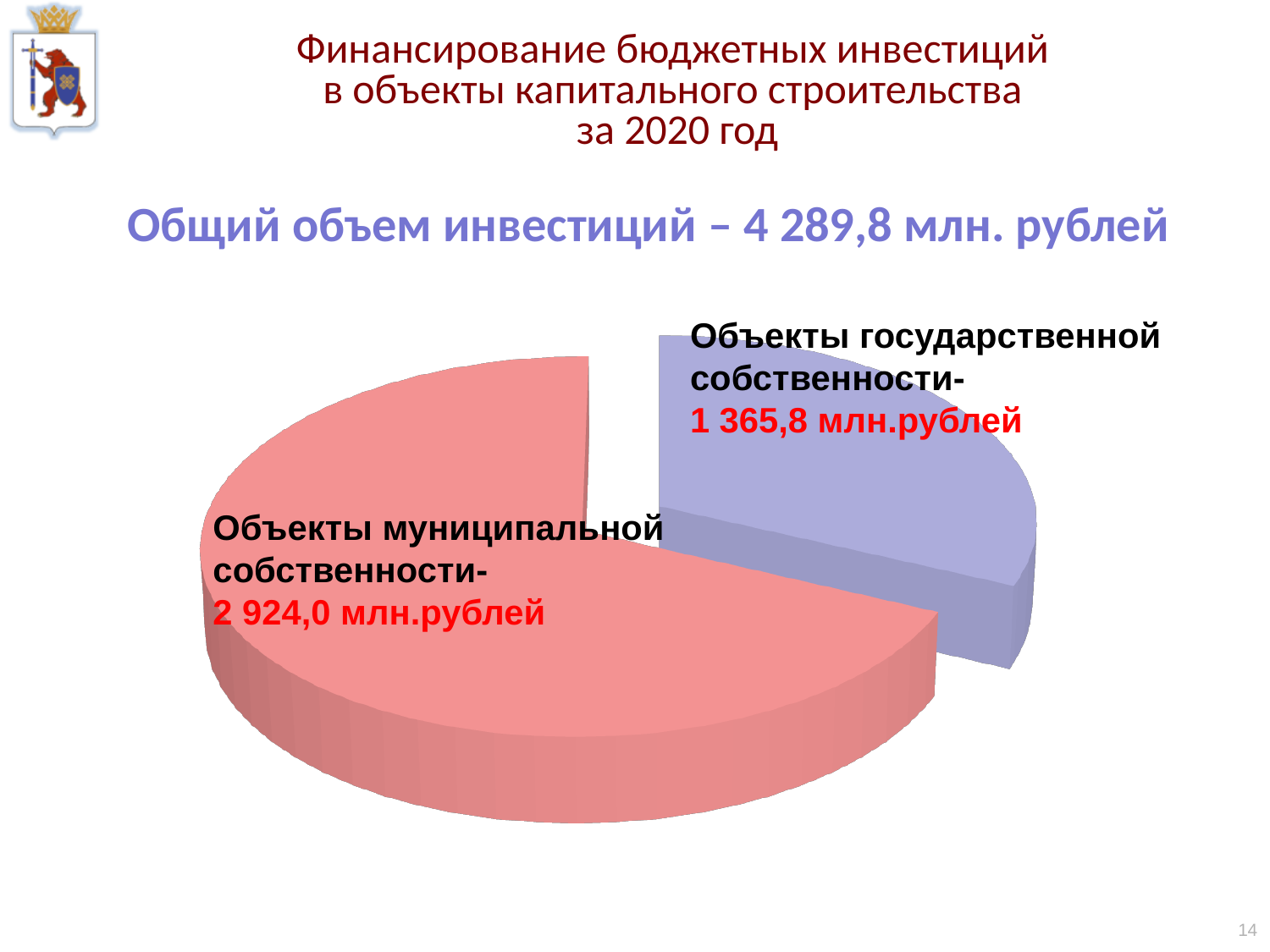
Which category has the smallest slice of the pie? Объекты государственной собственности What is the value for Объекты муниципальной собственности? 2 924,0 млн.рублей How many slices does the pie chart have? 2 Which category has the largest slice of the pie? Объекты муниципальной собственности What is the value for Объекты государственной собственности? 1 365,8 млн.рублей What colour is the slice for Объекты государственной собственности? Blue Which is larger: the value for Объекты муниципальной собственности or for Объекты государственной собственности? Объекты муниципальной собственности What is the total of the two slices in the pie chart? 4 289,8 млн. рублей What total investment volume is stated on the slide? 4 289,8 млн. рублей Which year does the chart on the slide cover? 2020 What type of chart is shown on the slide? Pie chart What is the difference between the value for Объекты муниципальной собственности and the value for Объекты государственной собственности? 1 558,2 млн.рублей